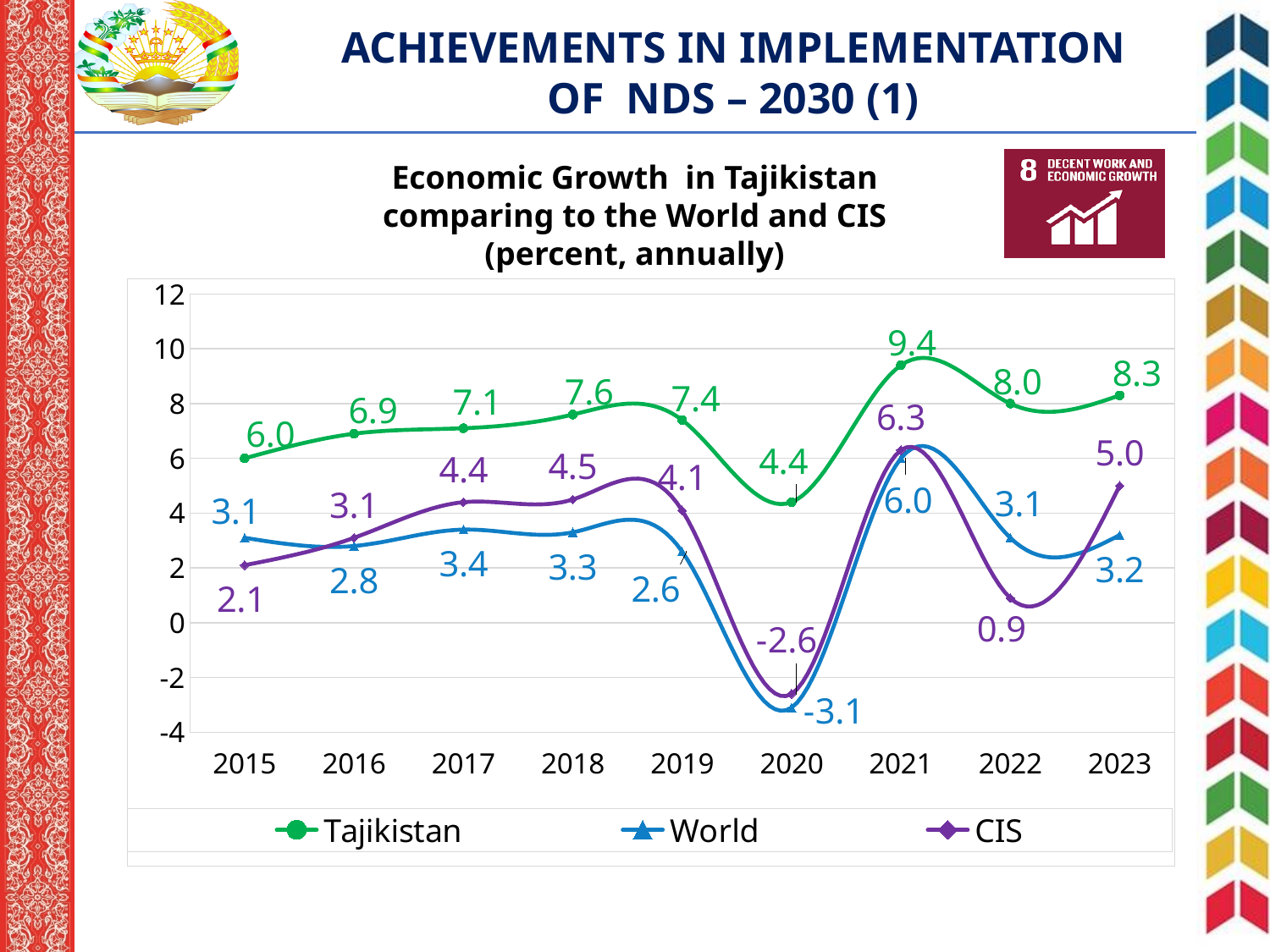
What kind of chart is shown on the slide? Line chart What was the CIS economic growth in 2022? 0.9 What is the difference between Tajikistan's growth and the World's growth in 2023? 5.1 How many series does the legend list? 3 What was the World's economic growth in 2020? -3.1 What was Tajikistan's economic growth in 2021? 9.4 How many years are shown on the x axis? 9 In which year did Tajikistan record its highest economic growth? 2021 In which year did the CIS record its lowest economic growth? 2020 Which colour is used for the Tajikistan line? Green Did Tajikistan's economic growth rise or fall from 2019 to 2020? Fall Which had higher economic growth in 2016, the World or the CIS? CIS